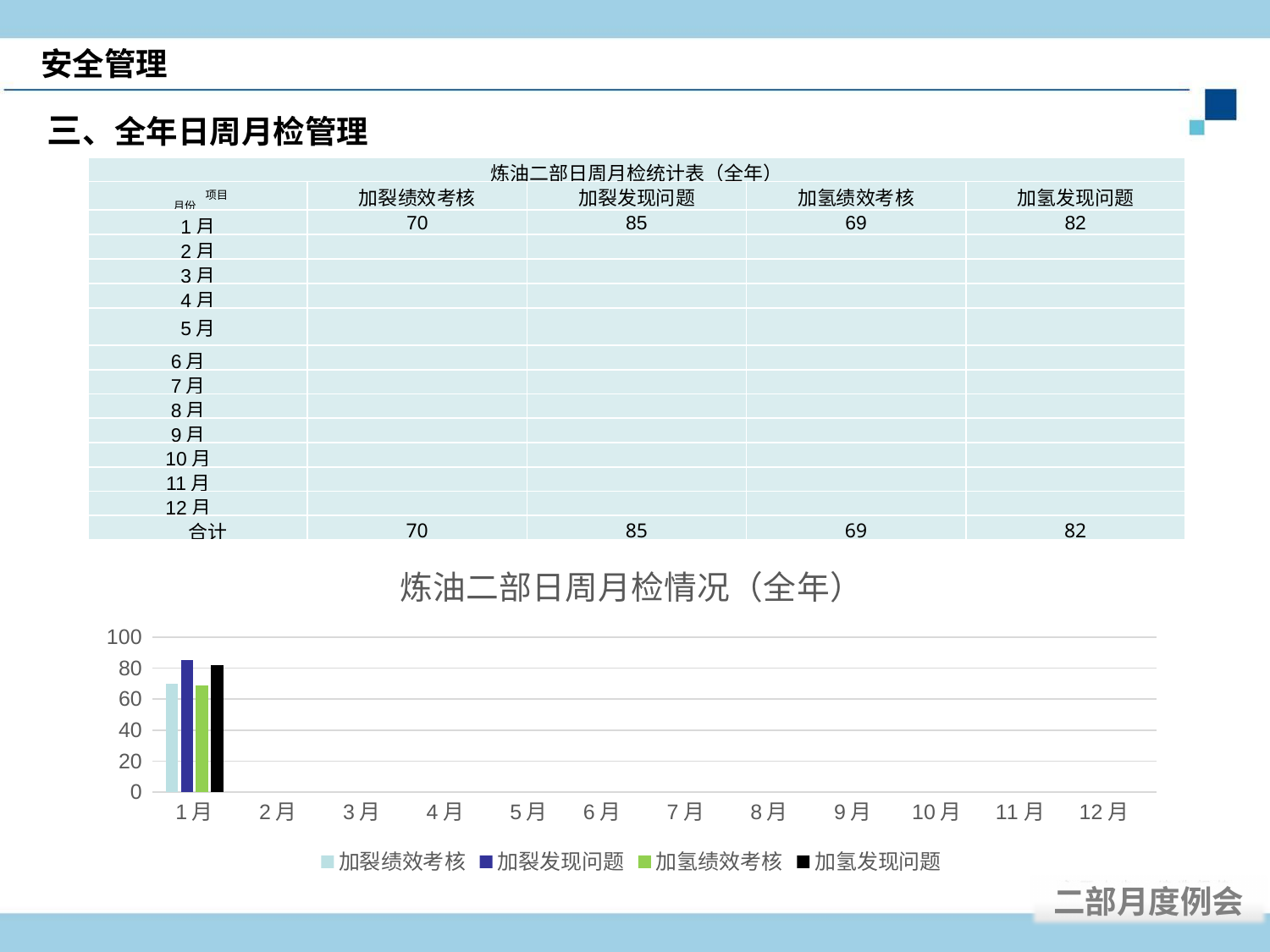
What is the value of 加氢发现问题 for 1月 in the chart? 82 How many month categories are shown on the x axis of the chart? 12 What is the value of 加氢绩效考核 for 1月 in the chart? 69 Which series has the lowest value for 1月 in the chart? 加氢绩效考核 How many series does the legend of the chart list? 4 What kind of chart is shown on the slide? bar chart What is the difference between 加裂发现问题 and 加裂绩效考核 for 1月? 15 What is the title of the chart? 炼油二部日周月检情况（全年） Is the value for 加裂绩效考核 in 1月 greater or less than 80? less For 1月, which is larger: 加氢发现问题 or 加裂绩效考核? 加氢发现问题 Which series has the highest value for 1月 in the chart? 加裂发现问题 What is the value of 加裂发现问题 for 1月 in the chart? 85